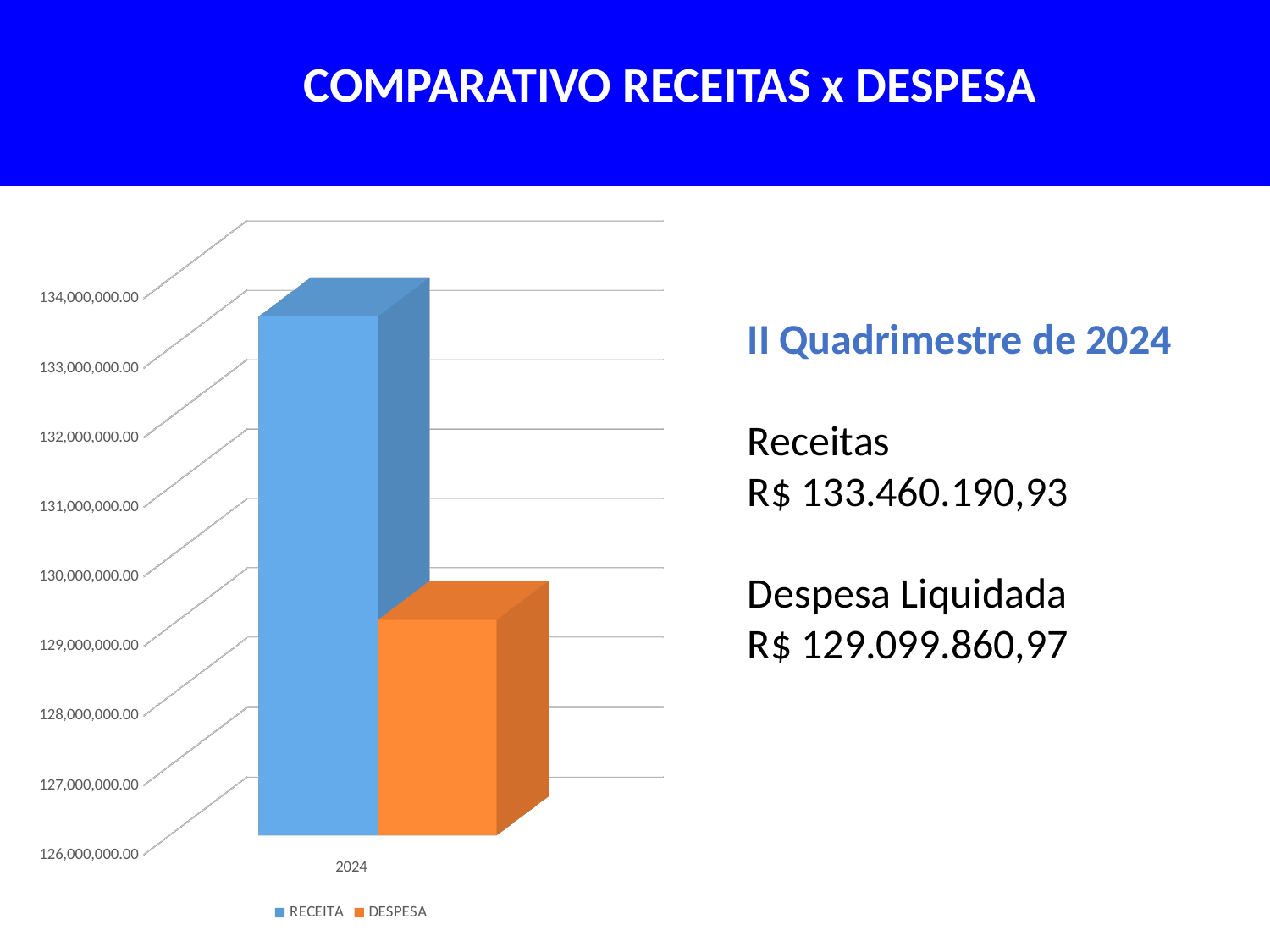
What kind of chart is shown on the slide? bar chart What is the title of the slide containing the chart? COMPARATIVO RECEITAS x DESPESA Is the value of the RECEITA bar greater or less than 133,000,000.00? greater According to the text on the slide, what is the value of Receitas for the II Quadrimestre de 2024? R$ 133.460.190,93 How many categories are shown on the x axis of the chart? 1 What colour is the RECEITA bar in the chart? blue Is the value of the DESPESA bar greater or less than 130,000,000.00? less Which series has the lowest value in the chart? DESPESA According to the text on the slide, what is the value of Despesa Liquidada for the II Quadrimestre de 2024? R$ 129.099.860,97 How many series does the chart legend list? 2 Which series has the highest value in the chart? RECEITA Which series has the taller bar in the chart, RECEITA or DESPESA? RECEITA